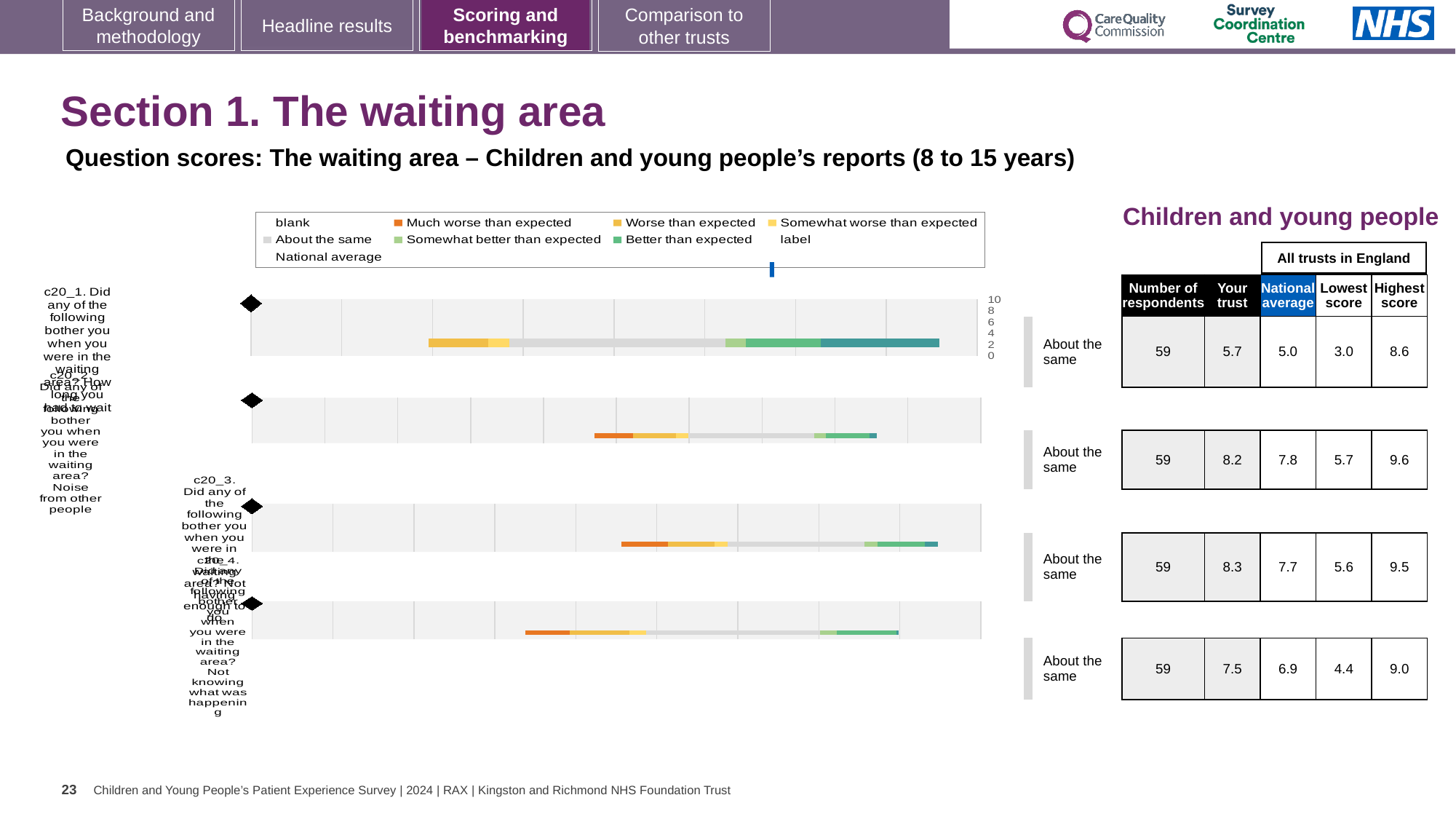
How many respondents are listed for the c20_1 question? 59 For the bottom chart (c20_4), what is the lowest score among all trusts in England? 4.4 For the bottom chart (c20_4), which is larger: the 'Your trust' score or the national average? Your trust For the top chart (c20_1), what is the difference between the 'Your trust' score and the national average? 0.7 Which question has the highest 'Your trust' score? c20_3 For the second chart (c20_2), what is the national average score? 7.8 What benchmark category is shown next to each of the four charts? About the same How many question charts (c20_1 to c20_4) are shown on the slide? 4 What kind of chart is used to show the question scores on this slide? bar chart For the third chart (c20_3), what is the highest score among all trusts in England? 9.5 Which question has the lowest 'Your trust' score? c20_1 For the top chart (c20_1), what is the 'Your trust' score shown in the table? 5.7